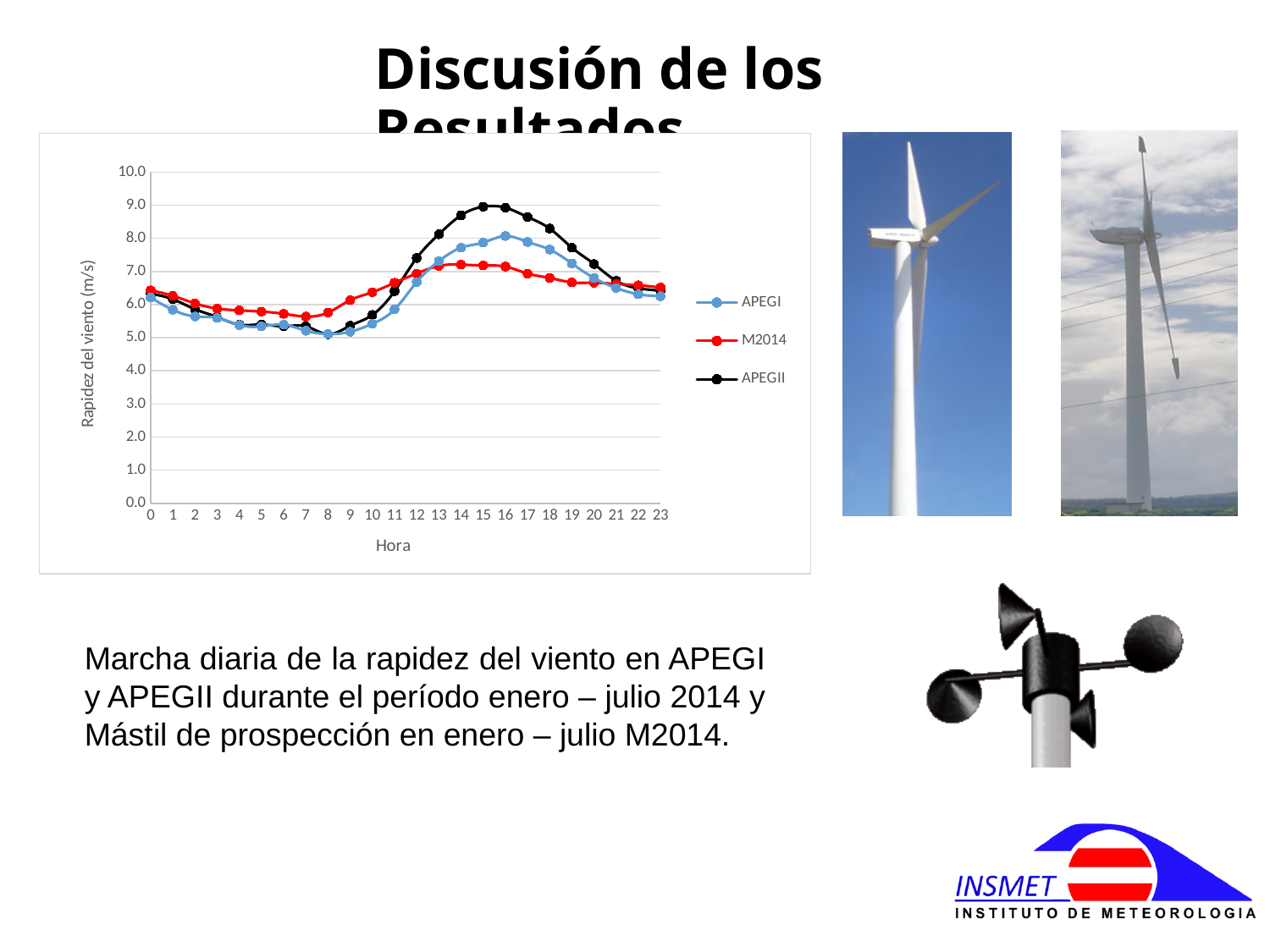
Is the value for M2014 at hour 15 greater or less than 8.0? less How many series does the chart legend list? 3 Does the APEGII series rise or fall between hour 8 and hour 15? rise Is the value for APEGI at hour 8 greater or less than 6.0? less How many hours are plotted along the x axis of the chart? 24 At hour 8, which series has the higher value, M2014 or APEGI? M2014 Which series is drawn in red in the chart? M2014 At hour 15, which series has the higher value, APEGII or M2014? APEGII What is the label of the y axis of the chart? Rapidez del viento (m/s) Is the value for APEGII at hour 15 greater or less than 8.0? greater What kind of chart is shown on the slide? line chart Which series reaches the highest wind speed in the chart? APEGII